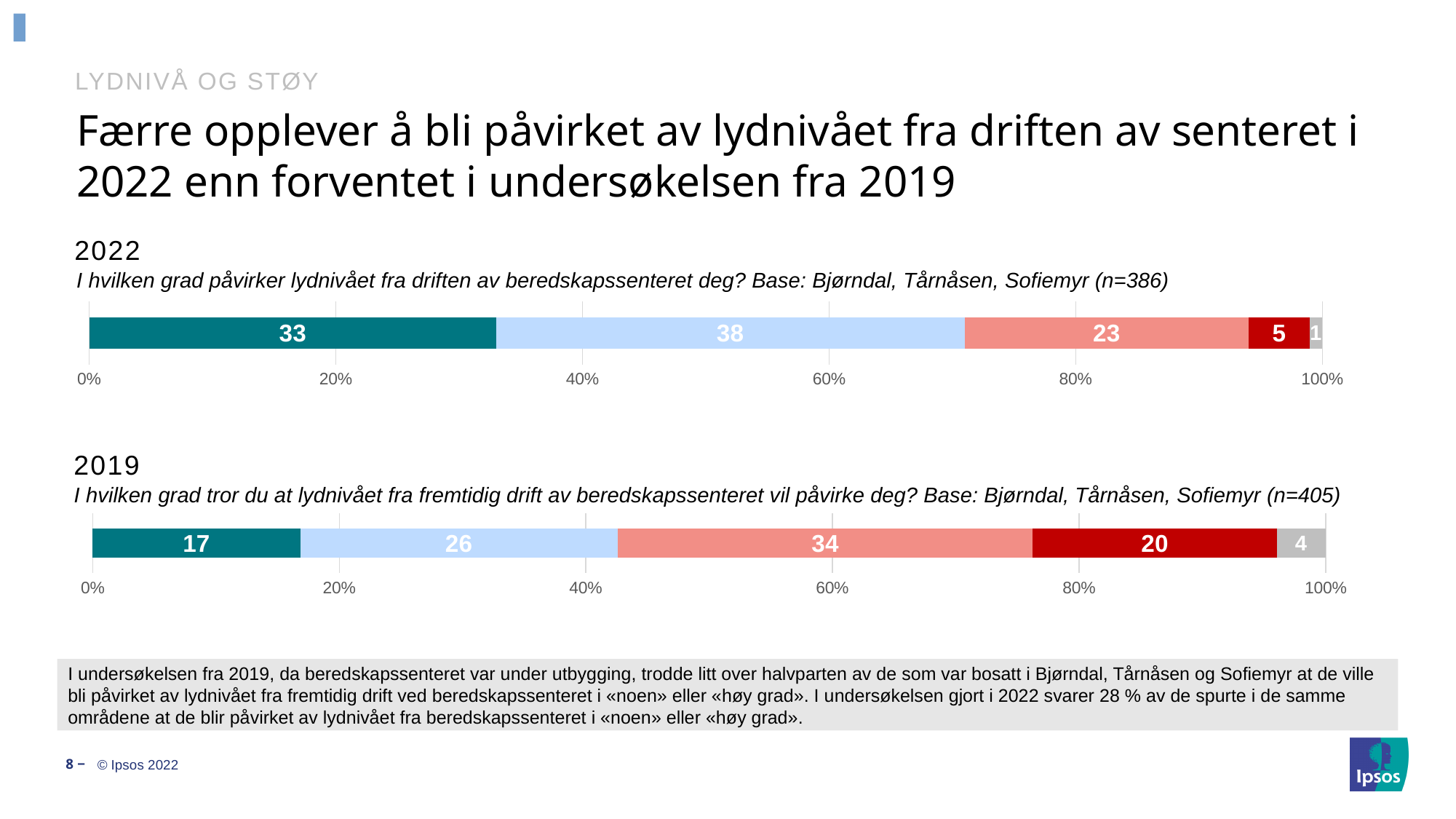
In the 2019 chart, is the value of the light red segment greater or less than 30? greater What is the difference between the dark teal segment in 2022 (33) and the dark teal segment in 2019 (17)? 16 Which is larger: the dark red segment in 2022 or the dark red segment in 2019? 2019 (20) How many segments does the 2022 stacked bar contain? 5 In the 2019 chart, which segment has the smallest value? The grey segment (4) In the 2022 chart, what is the value of the first (dark teal) segment? 33 In the 2019 chart, what is the value of the dark red segment? 20 What is the base size (n) shown for the 2019 chart? n=405 In the 2022 chart, which segment has the largest value? The light blue segment (38) In the 2019 chart, what is the value of the last (grey) segment? 4 In the 2022 chart, what is the value of the light blue segment? 38 What type of chart is used on this slide? Stacked bar chart